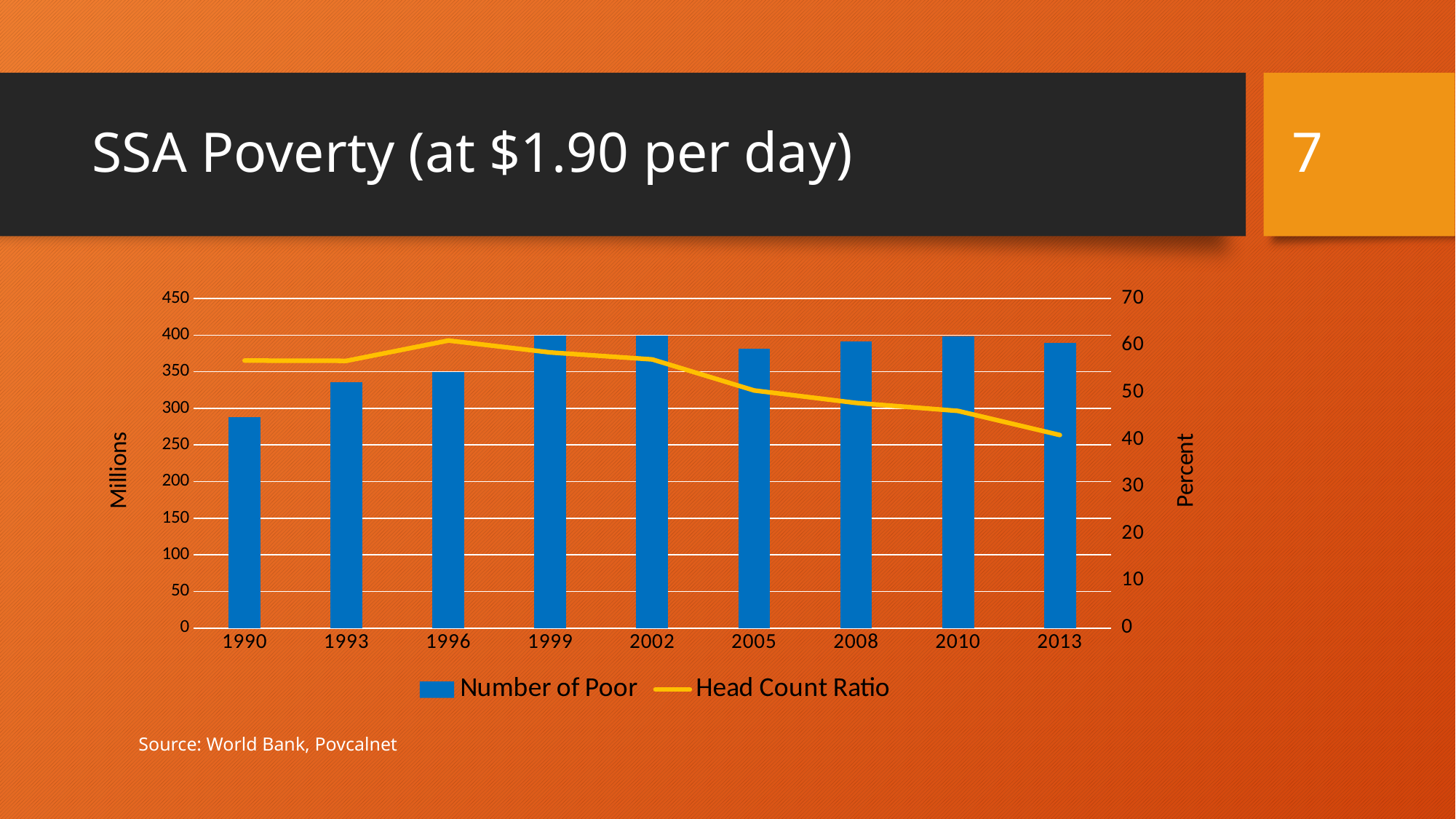
In which year is the Head Count Ratio line at its highest? 1996 Which year has the larger Number of Poor, 1990 or 1993? 1993 Which year has the lowest Number of Poor bar? 1990 What is the label on the left vertical axis of the chart? Millions How many series does the chart's legend list? 2 Is the Number of Poor for 1990 greater or less than 300 million? less Is the Head Count Ratio for 2013 greater or less than 50 percent? less What kind of chart is shown on the slide? Combined bar and line chart Is the Number of Poor for 1999 greater or less than 350 million? greater How many years are shown on the x axis of the chart? 9 Does the Head Count Ratio line rise or fall overall from 1990 to 2013? fall In which year is the Head Count Ratio line at its lowest? 2013